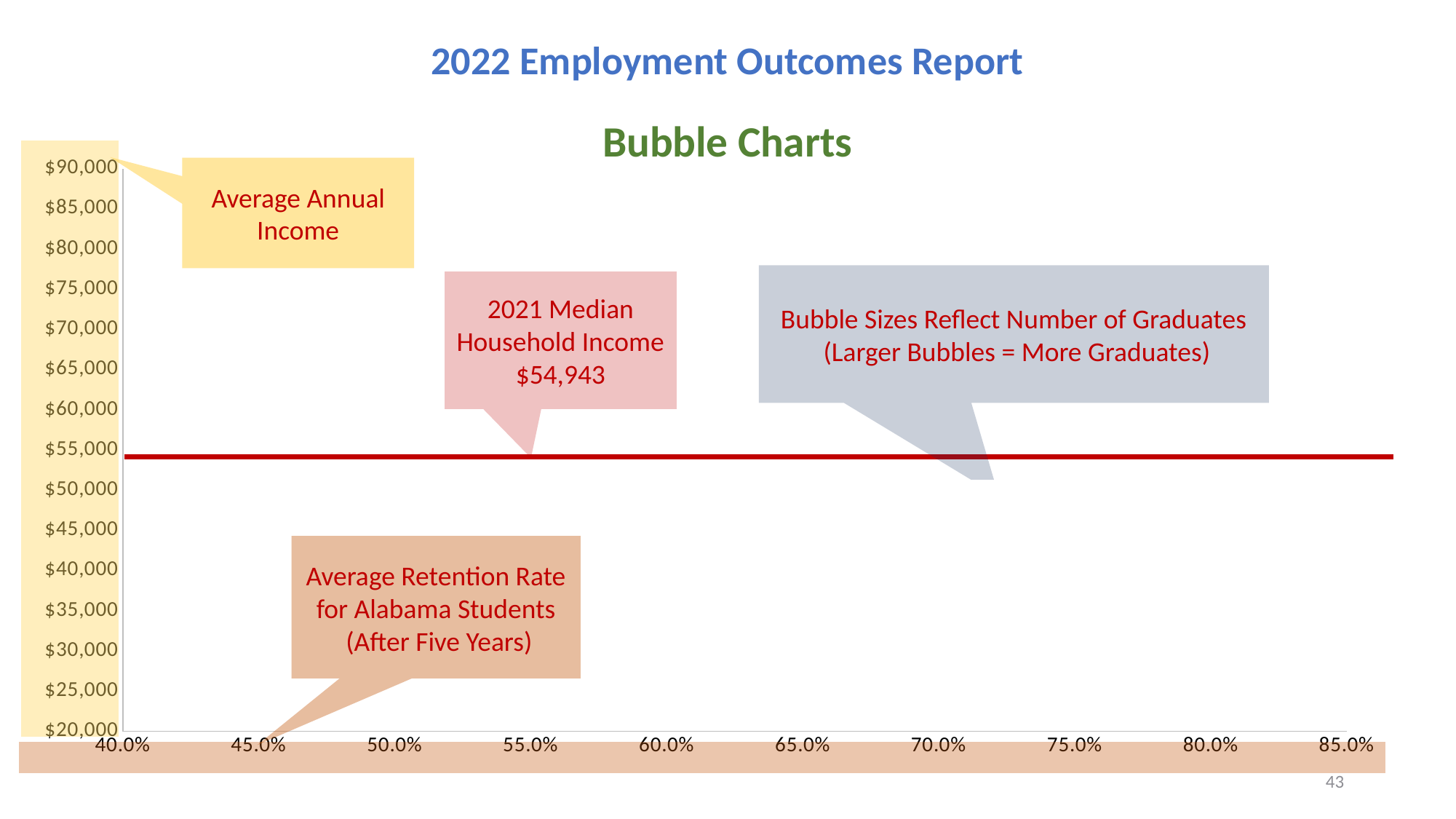
According to the callout, what do the bubble sizes reflect? Number of Graduates Is the 2021 Median Household Income line greater or less than $60,000? less What does the vertical axis of the chart represent? Average Annual Income What value does the red horizontal line labelled 2021 Median Household Income mark? $54,943 Is the 2021 Median Household Income line greater or less than $50,000? greater What kind of chart is shown on the slide? Bubble chart